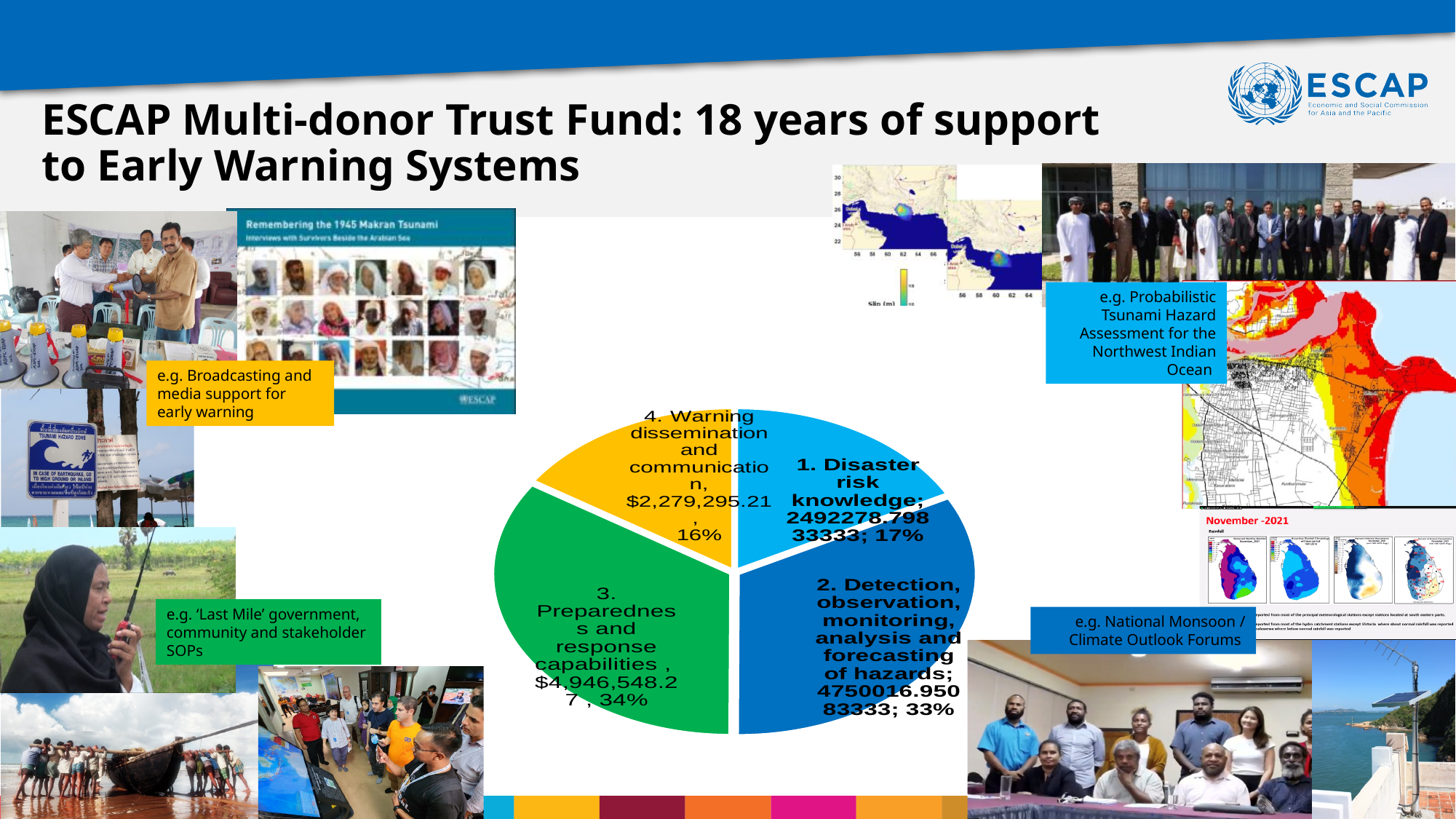
What percentage share does the '1. Disaster risk knowledge' slice have in the pie chart? 17% What is the difference in percentage points between the '3. Preparedness and response capabilities' share and the '4. Warning dissemination and communication' share? 18 percentage points Which slice of the pie chart has the smallest share? 4. Warning dissemination and communication What percentage share does the '4. Warning dissemination and communication' slice have? 16% What dollar value is shown for '3. Preparedness and response capabilities'? $4,946,548.27 What kind of chart is shown in the centre of the slide? Pie chart Which slice of the pie chart has the largest share? 3. Preparedness and response capabilities What dollar value is shown for '4. Warning dissemination and communication'? $2,279,295.21 How many slices does the pie chart have? 4 What percentage share does the '2. Detection, observation, monitoring, analysis and forecasting of hazards' slice have? 33% Which is larger: the value for '3. Preparedness and response capabilities' or for '4. Warning dissemination and communication'? 3. Preparedness and response capabilities